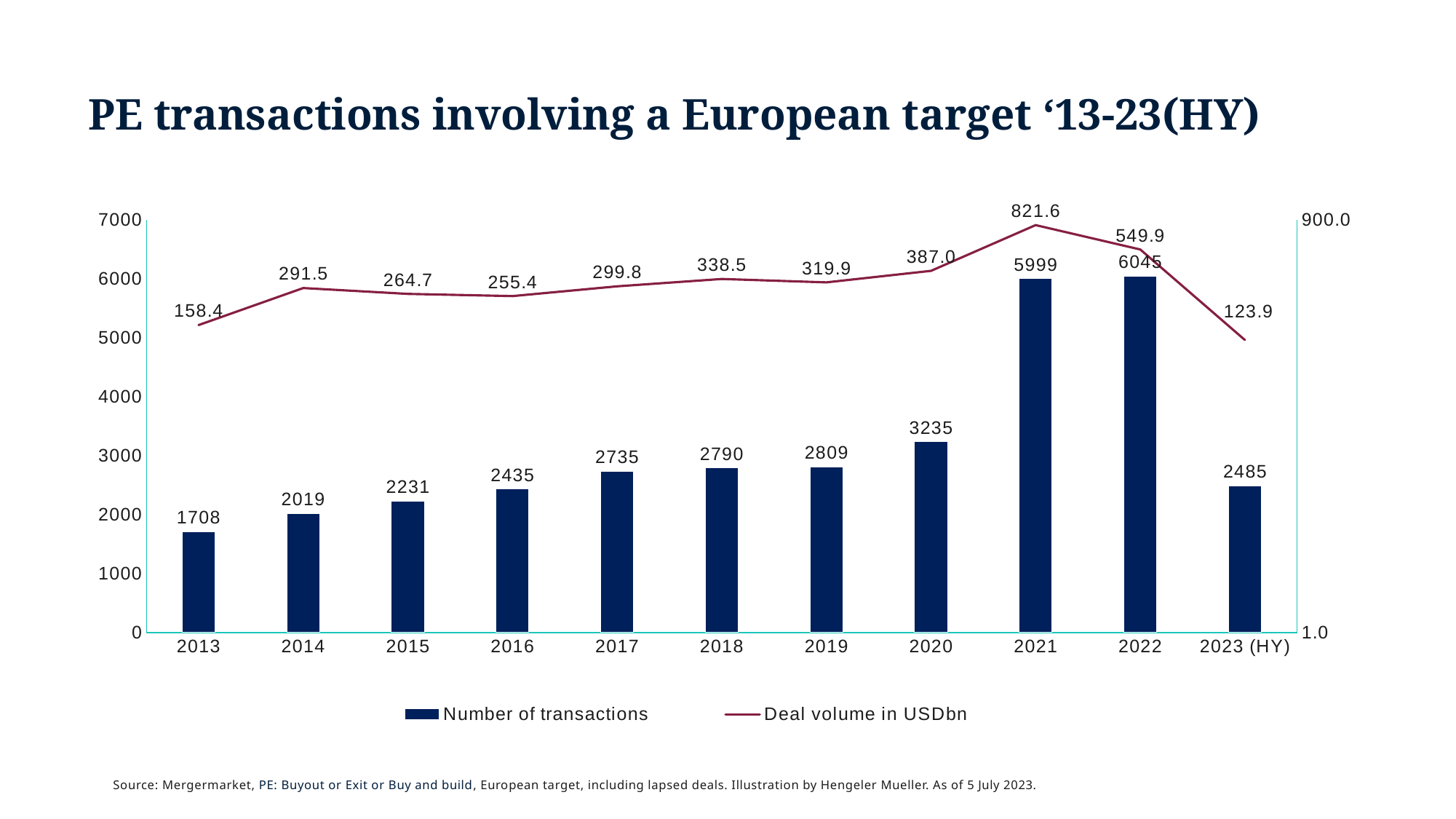
What is the deal volume in USDbn for 2013? 158.4 How many series does the legend list? 2 Does the number of transactions rise or fall from 2013 to 2020? rise Which year has the highest number of transactions? 2022 What is the difference in deal volume in USDbn between 2021 and 2022? 271.7 Which year has a larger number of transactions, 2020 or 2023 (HY)? 2020 Which year has the highest deal volume in USDbn? 2021 How many years are shown on the x axis? 11 Which year has the lowest number of transactions? 2013 What is the number of transactions in 2021? 5999 What is the deal volume in USDbn for 2023 (HY)? 123.9 What is the difference in the number of transactions between 2022 and 2021? 46